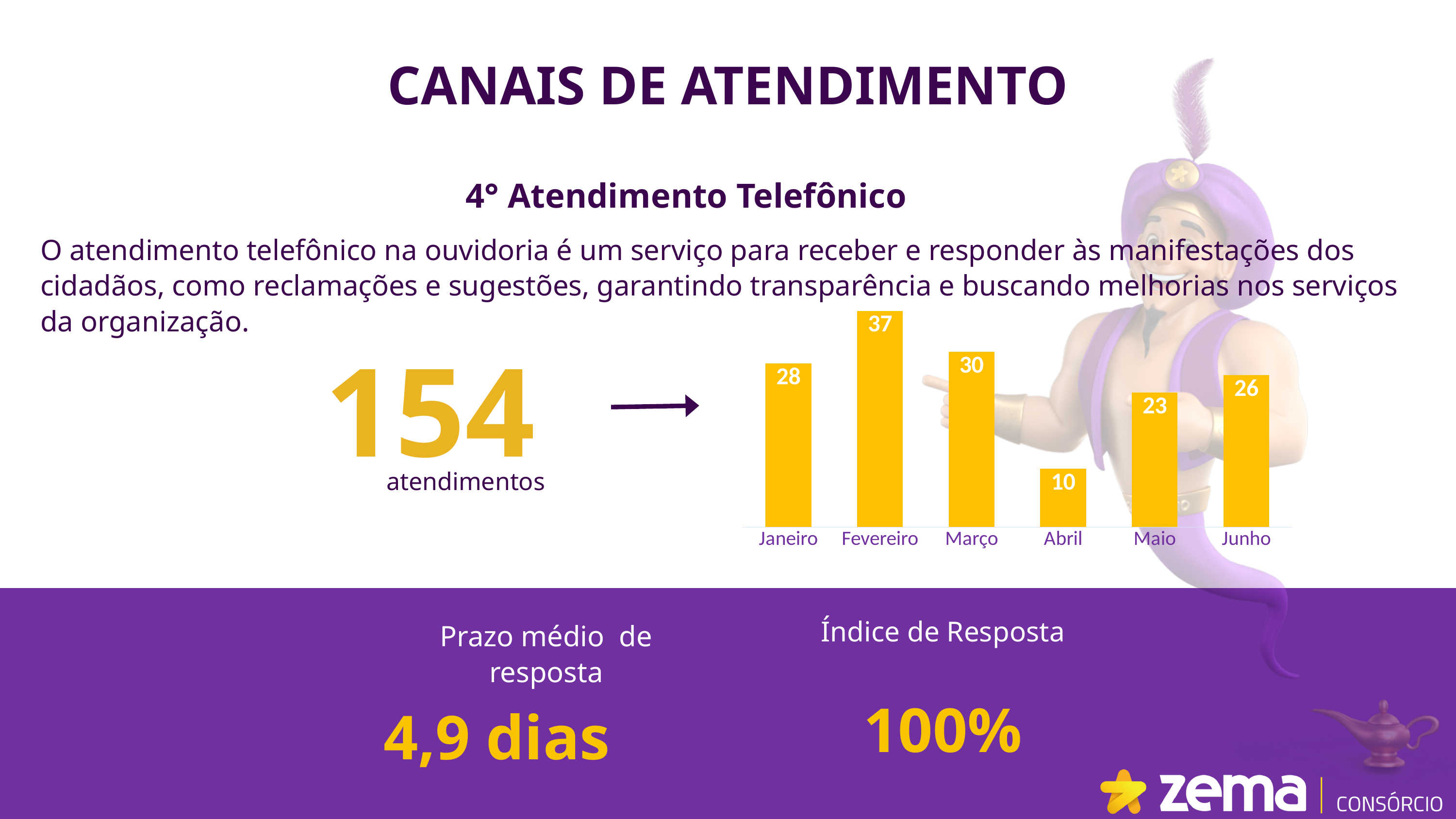
What is the difference between the values for Fevereiro and Abril? 27 Do the values rise or fall from Fevereiro to Abril? fall What is the difference between the values for Março and Maio? 7 What is the value for Junho in the bar chart? 26 What is the value for Abril in the bar chart? 10 What colour are the bars in the chart? yellow Which month has the lowest value in the bar chart? Abril What is the value for Fevereiro in the bar chart? 37 Which month has the highest value in the bar chart? Fevereiro What kind of chart is shown on the slide? bar chart Which is larger, the value for Janeiro or the value for Junho? Janeiro How many months are shown in the bar chart? 6